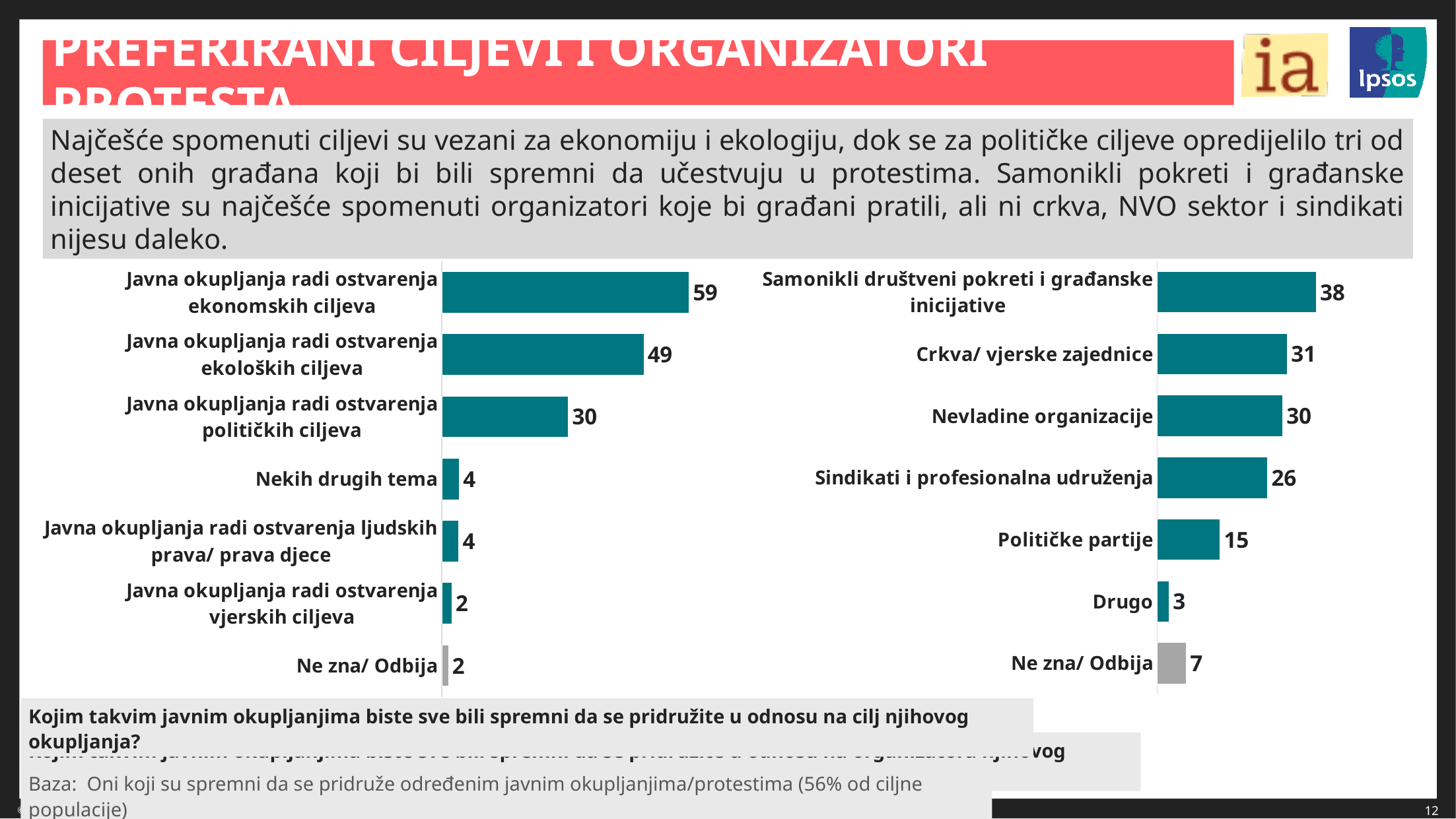
What type of chart is the right chart? Bar chart In the left chart, what is the value for 'Javna okupljanja radi ostvarenja političkih ciljeva'? 30 In the left chart, which category has the highest value? Javna okupljanja radi ostvarenja ekonomskih ciljeva In the right chart, what is the value for 'Političke partije'? 15 In the right chart, which category has the lowest value? Drugo In the right chart, what is the value for 'Crkva/ vjerske zajednice'? 31 In the left chart, what is the value for 'Javna okupljanja radi ostvarenja ekonomskih ciljeva'? 59 In the right chart, which category has the highest value? Samonikli društveni pokreti i građanske inicijative How many categories does the left chart show? 7 In the right chart, which is larger: 'Crkva/ vjerske zajednice' or 'Sindikati i profesionalna udruženja'? Crkva/ vjerske zajednice In the right chart, what is the difference between 'Nevladine organizacije' and 'Sindikati i profesionalna udruženja'? 4 In the left chart, what is the difference between the values for ekonomskih ciljeva and ekoloških ciljeva? 10